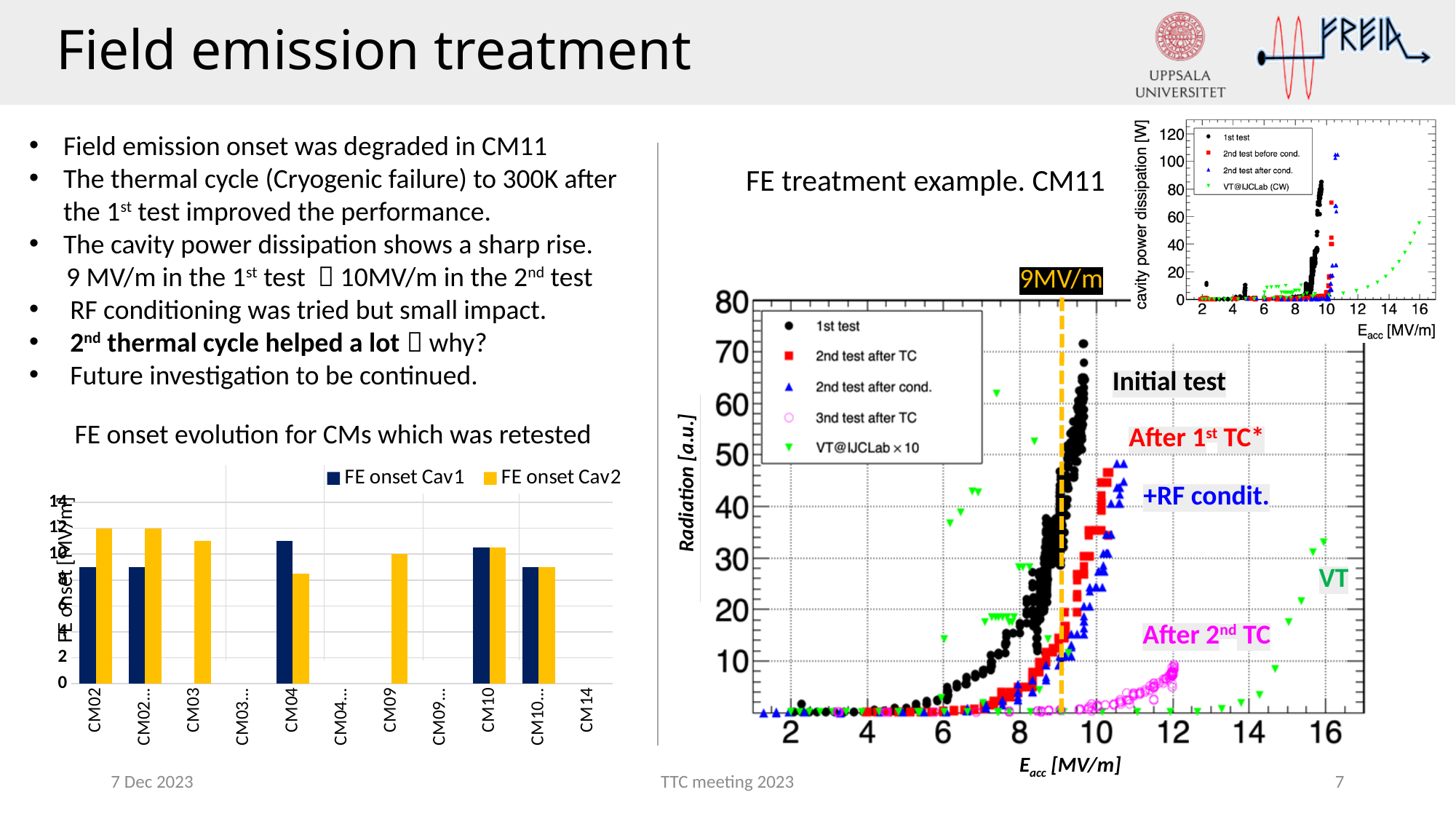
How many series does the legend of the 'FE treatment example. CM11' scatter chart list? 5 In the 'FE onset evolution for CMs which was retested' chart, is the FE onset Cav2 value for CM04 greater or less than 10? less In the 'FE onset evolution for CMs which was retested' chart, is the FE onset Cav2 value for CM02 greater or less than 10? greater What is the y-axis label of the 'FE treatment example. CM11' scatter chart? Radiation [a.u.] What kind of chart is 'FE onset evolution for CMs which was retested'? bar chart In the 'FE onset evolution for CMs which was retested' chart, is the FE onset Cav1 value for CM02 greater or less than 10? less In the 'FE treatment example. CM11' chart, at what E_acc value is the dashed vertical line drawn? 9MV/m In the 'FE onset evolution for CMs which was retested' chart, which is larger for CM02: FE onset Cav1 or FE onset Cav2? FE onset Cav2 In the 'FE onset evolution for CMs which was retested' chart, which is larger for CM04: FE onset Cav1 or FE onset Cav2? FE onset Cav1 In the 'FE onset evolution for CMs which was retested' chart, which series is drawn in yellow? FE onset Cav2 In the 'FE onset evolution for CMs which was retested' chart, how many categories are shown on the x axis? 11 How many series does the legend of the 'FE onset evolution for CMs which was retested' chart list? 2